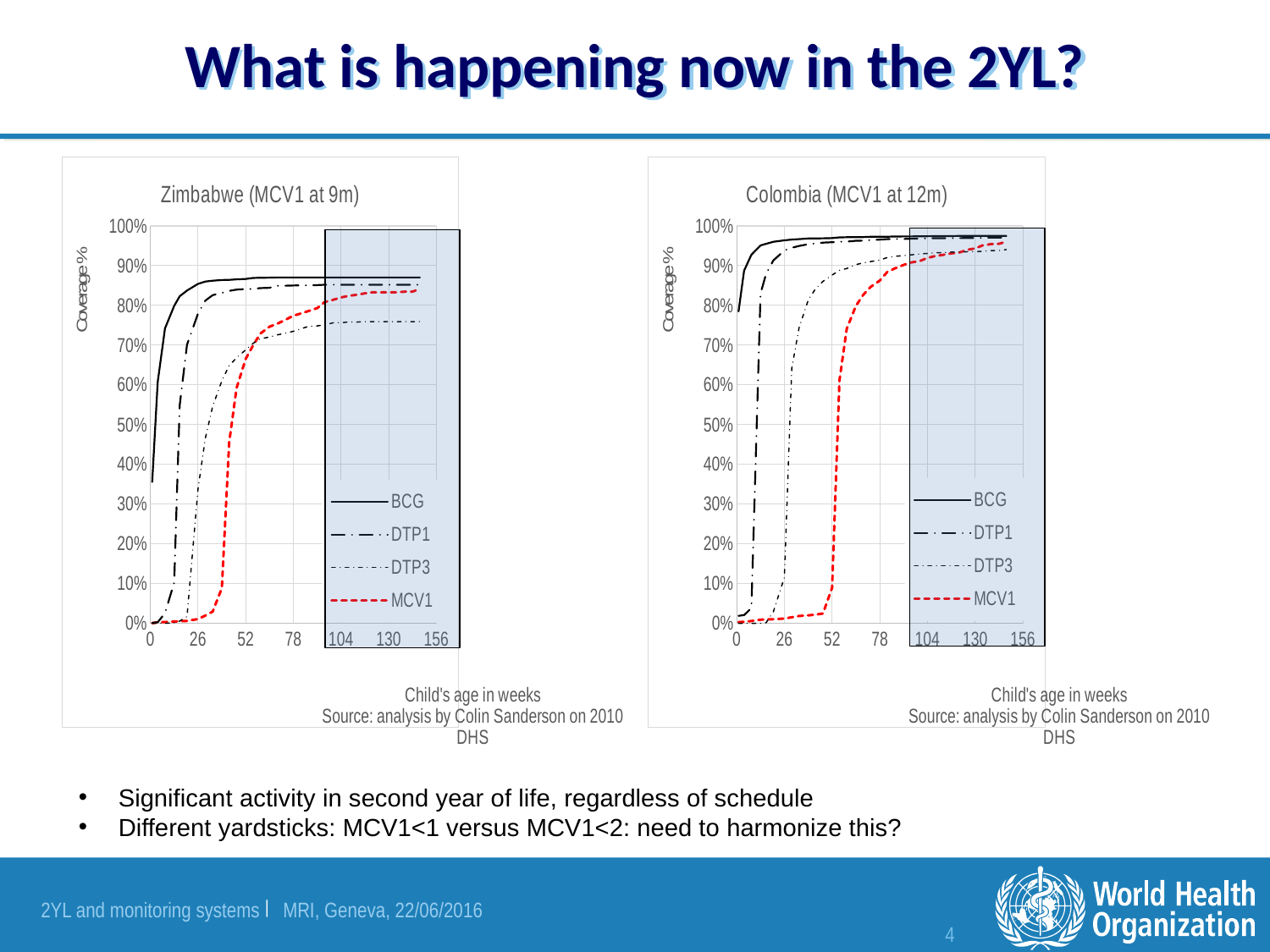
In the Colombia (MCV1 at 12m) chart, is the MCV1 coverage at 26 weeks greater or less than 10%? less In the Colombia (MCV1 at 12m) chart, does the MCV1 coverage rise or fall as the child's age in weeks increases? rise In the Zimbabwe (MCV1 at 9m) chart, which series has the lowest coverage at 156 weeks? DTP3 In the Colombia (MCV1 at 12m) chart, is the BCG coverage at 26 weeks greater or less than 90%? greater What kind of chart is the Zimbabwe (MCV1 at 9m) chart? line chart How many series does the legend of the Colombia (MCV1 at 12m) chart list? 4 In the Zimbabwe (MCV1 at 9m) chart, is the MCV1 coverage at 26 weeks greater or less than 10%? less What is the x-axis label of the Colombia (MCV1 at 12m) chart? Child's age in weeks Which series are listed in the legend of the Zimbabwe (MCV1 at 9m) chart? BCG, DTP1, DTP3, MCV1 In the Zimbabwe (MCV1 at 9m) chart, at 156 weeks, which is higher: MCV1 or DTP3? MCV1